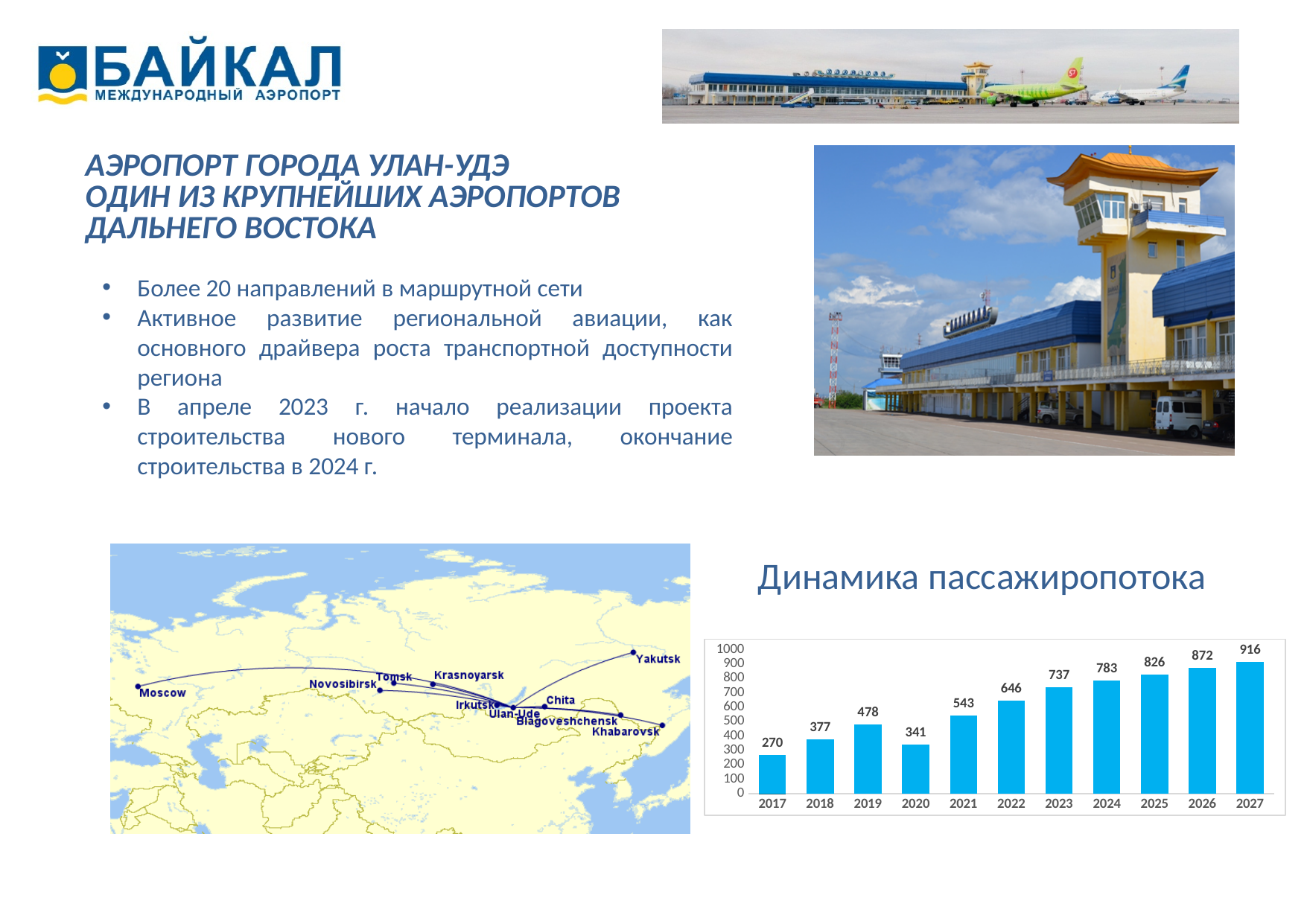
What is the value for 2024 in the 'Динамика пассажиропотока' chart? 783 What is the difference between the values for 2019 and 2020 in the 'Динамика пассажиропотока' chart? 137 What is the value for 2020 in the 'Динамика пассажиропотока' chart? 341 How many years are shown on the x axis of the 'Динамика пассажиропотока' chart? 11 Which year has the lowest value in the 'Динамика пассажиропотока' chart? 2017 What is the difference between the values for 2027 and 2017 in the 'Динамика пассажиропотока' chart? 646 Is the value for 2023 in the 'Динамика пассажиропотока' chart greater or less than 700? greater What kind of chart is 'Динамика пассажиропотока'? bar chart Which year has the highest value in the 'Динамика пассажиропотока' chart? 2027 Do the values in the 'Динамика пассажиропотока' chart generally rise or fall from 2020 to 2027? rise Which is larger in the 'Динамика пассажиропотока' chart, the value for 2019 or the value for 2020? 2019 What is the value for 2017 in the 'Динамика пассажиропотока' chart? 270